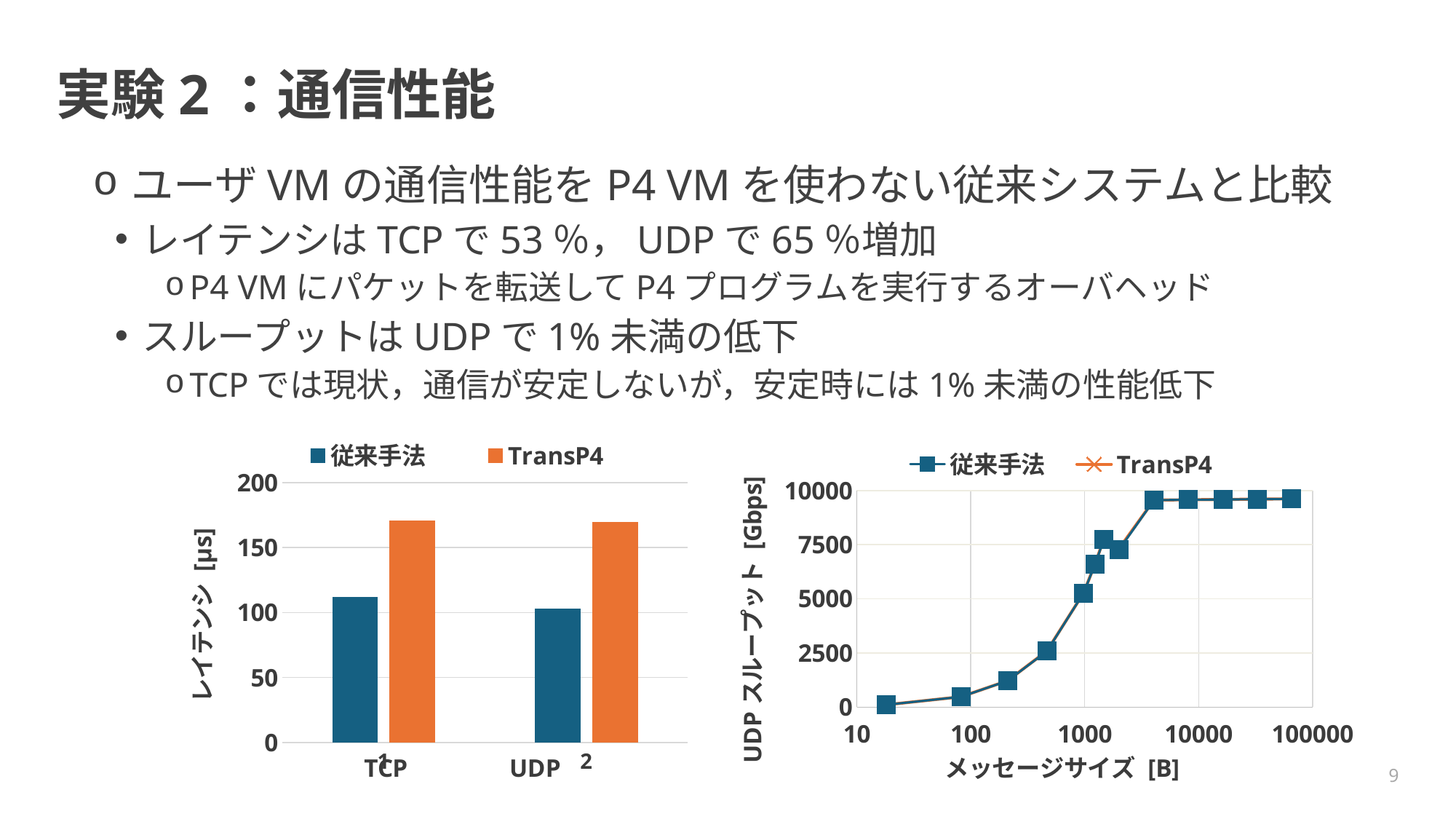
In the left chart (レイテンシ), is the TransP4 value for UDP greater or less than 150? greater In the left chart (レイテンシ), how many categories are shown on the x axis? 2 In the left chart (レイテンシ), which series has the higher latency for UDP, 従来手法 or TransP4? TransP4 In the left chart (レイテンシ), which series has the higher latency for TCP, 従来手法 or TransP4? TransP4 In the left chart (レイテンシ), how many series does the legend list? 2 What kind of chart is the right chart (UDP スループット)? line chart In the right chart (UDP スループット), how many series does the legend list? 2 What kind of chart is the left chart (レイテンシ)? bar chart In the right chart (UDP スループット), does throughput rise or fall as message size increases? rise In the left chart (レイテンシ), is the 従来手法 value for TCP greater or less than 150? less In the right chart (UDP スループット), what is the label of the x axis? メッセージサイズ [B] In the left chart (レイテンシ), is the TransP4 value for TCP greater or less than 150? greater